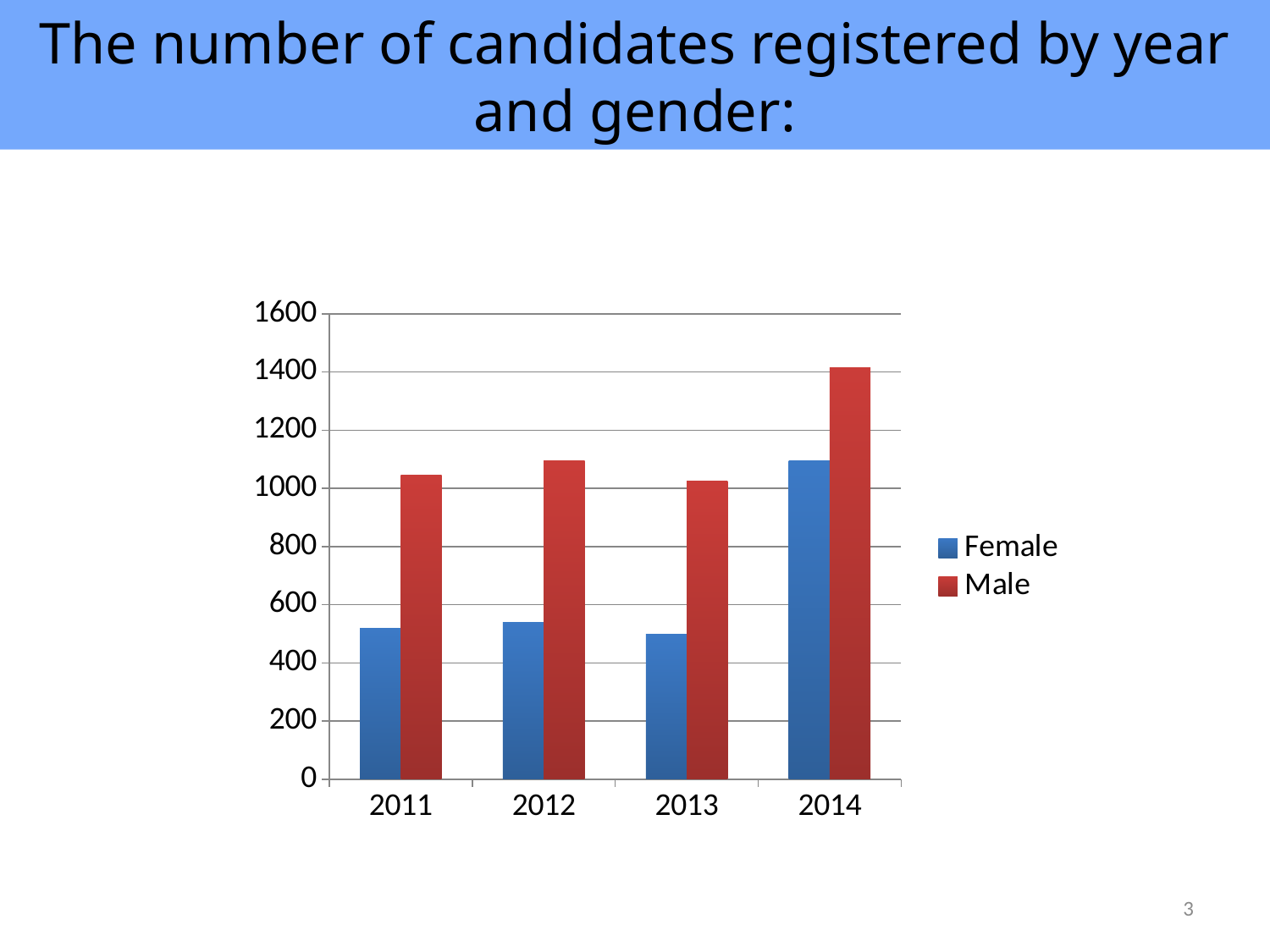
What is the title of the slide containing the chart? The number of candidates registered by year and gender: Is the Male value for 2012 greater or less than 1000? greater How many years are shown on the x axis of the chart? 4 Which colour represents the Female series in the chart? blue Is the Female value for 2014 greater or less than 1000? greater In which year is the Male bar the highest? 2014 Is the Female value for 2011 greater or less than 600? less What kind of chart is shown on the slide? bar chart How many series does the chart's legend list? 2 In which year is the Female bar the highest? 2014 In 2011, which is larger, the Female value or the Male value? Male